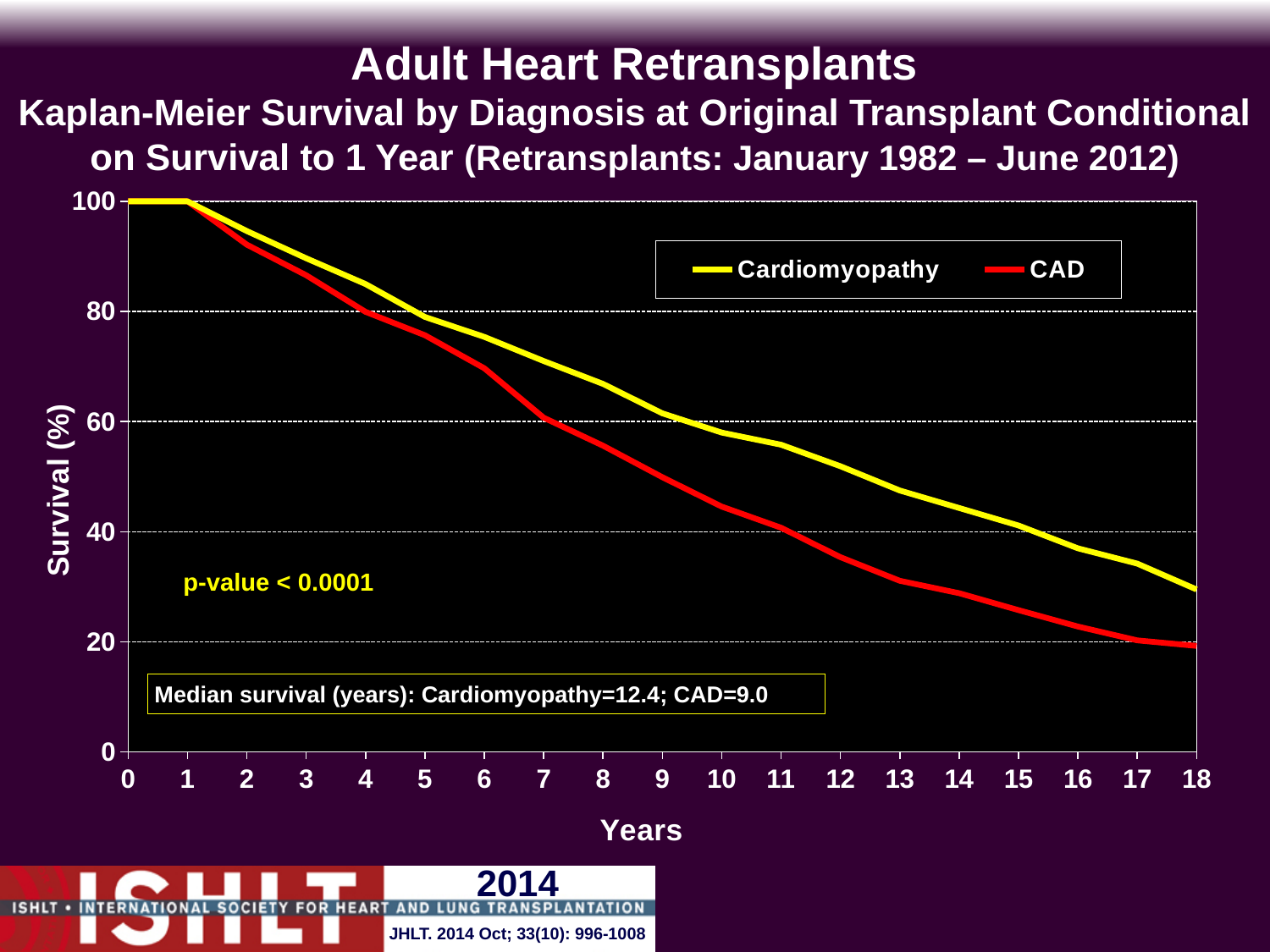
Is the survival value for Cardiomyopathy at 18 years greater or less than 40? less Do the survival curves rise or fall as years increase? Fall Which series has the higher survival at 10 years, Cardiomyopathy or CAD? Cardiomyopathy What is the median survival in years for Cardiomyopathy, as printed on the slide? 12.4 What is the label of the y axis? Survival (%) How many series does the legend list? 2 Which two series are listed in the legend? Cardiomyopathy and CAD What p-value is printed on the chart? p-value < 0.0001 Is the survival value for CAD at 6 years greater or less than 80? less What kind of chart is shown on the slide? Line chart Is the survival value for CAD at 13 years greater or less than 40? less What is the median survival in years for CAD, as printed on the slide? 9.0